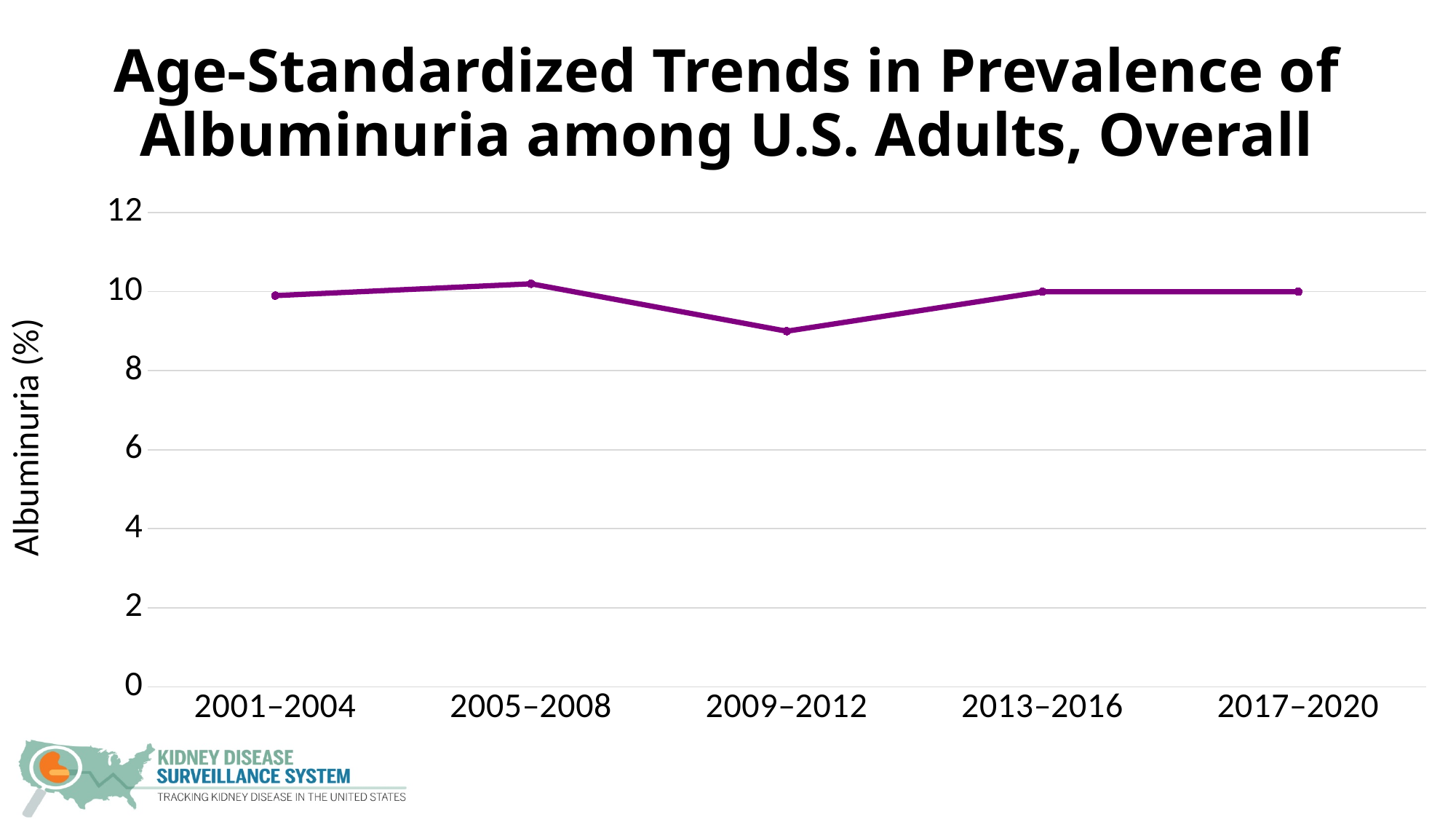
Does the line rise or fall from 2005–2008 to 2009–2012? fall Is the value for 2001–2004 greater or less than 8? greater What is the label on the y axis? Albuminuria (%) Which is larger, the value for 2005–2008 or the value for 2009–2012? 2005–2008 Is the value for 2009–2012 greater or less than 10? less Which is larger, the value for 2009–2012 or the value for 2013–2016? 2013–2016 What kind of chart is shown on the slide? line chart Is the value for 2005–2008 greater or less than 10? greater How many time periods are plotted on the x axis? 5 What is the title of the chart? Age-Standardized Trends in Prevalence of Albuminuria among U.S. Adults, Overall Which time period has the lowest albuminuria prevalence? 2009–2012